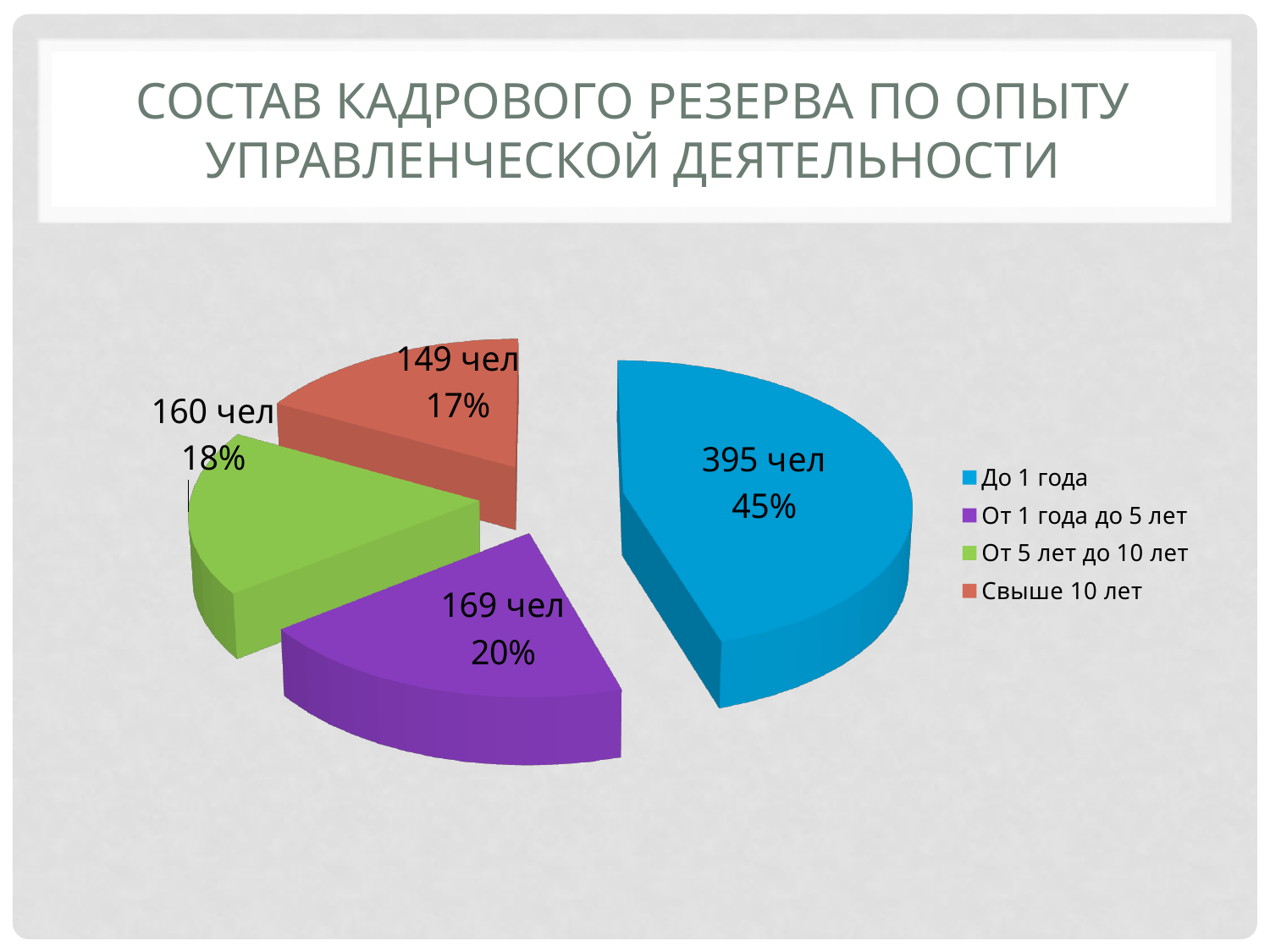
What share of the pie does 'От 1 года до 5 лет' represent? 20% What colour is the slice for 'От 1 года до 5 лет'? purple Which has more people: 'От 5 лет до 10 лет' or 'Свыше 10 лет'? От 5 лет до 10 лет What kind of chart is shown on the slide? pie chart How many people are in the 'До 1 года' category? 395 чел How many categories does the pie chart have? 4 How many people are in the 'От 5 лет до 10 лет' category? 160 чел Which category has the smallest share of the pie? Свыше 10 лет Which category has the largest share of the pie? До 1 года What is the title of the slide? Состав кадрового резерва по опыту управленческой деятельности What is the difference in people between 'До 1 года' and 'От 1 года до 5 лет'? 226 чел What percentage is shown for 'Свыше 10 лет'? 17%